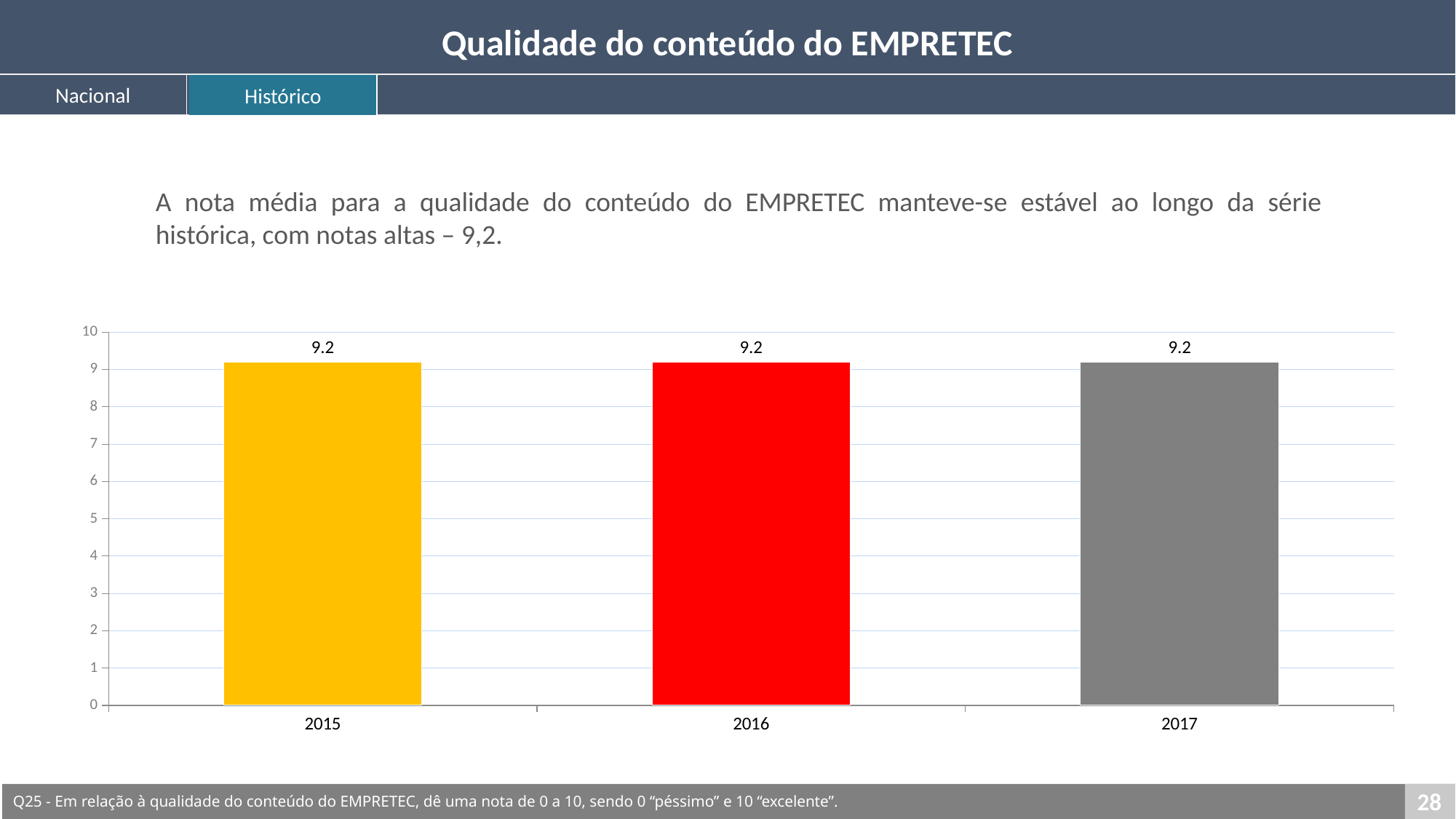
What is the difference between the values for 2015 and 2017? 0 What is the value for 2017? 9.2 What is the value for 2015? 9.2 Do the values rise, fall or stay the same from 2015 to 2017? stay the same What colour is the bar for 2016? red What is the maximum value shown on the y axis? 10 What kind of chart is shown on the slide? bar chart Is the value for 2016 greater or less than 8? greater Is the value for 2017 greater or less than 10? less What is the value for 2016? 9.2 How many years are shown on the x axis of the chart? 3